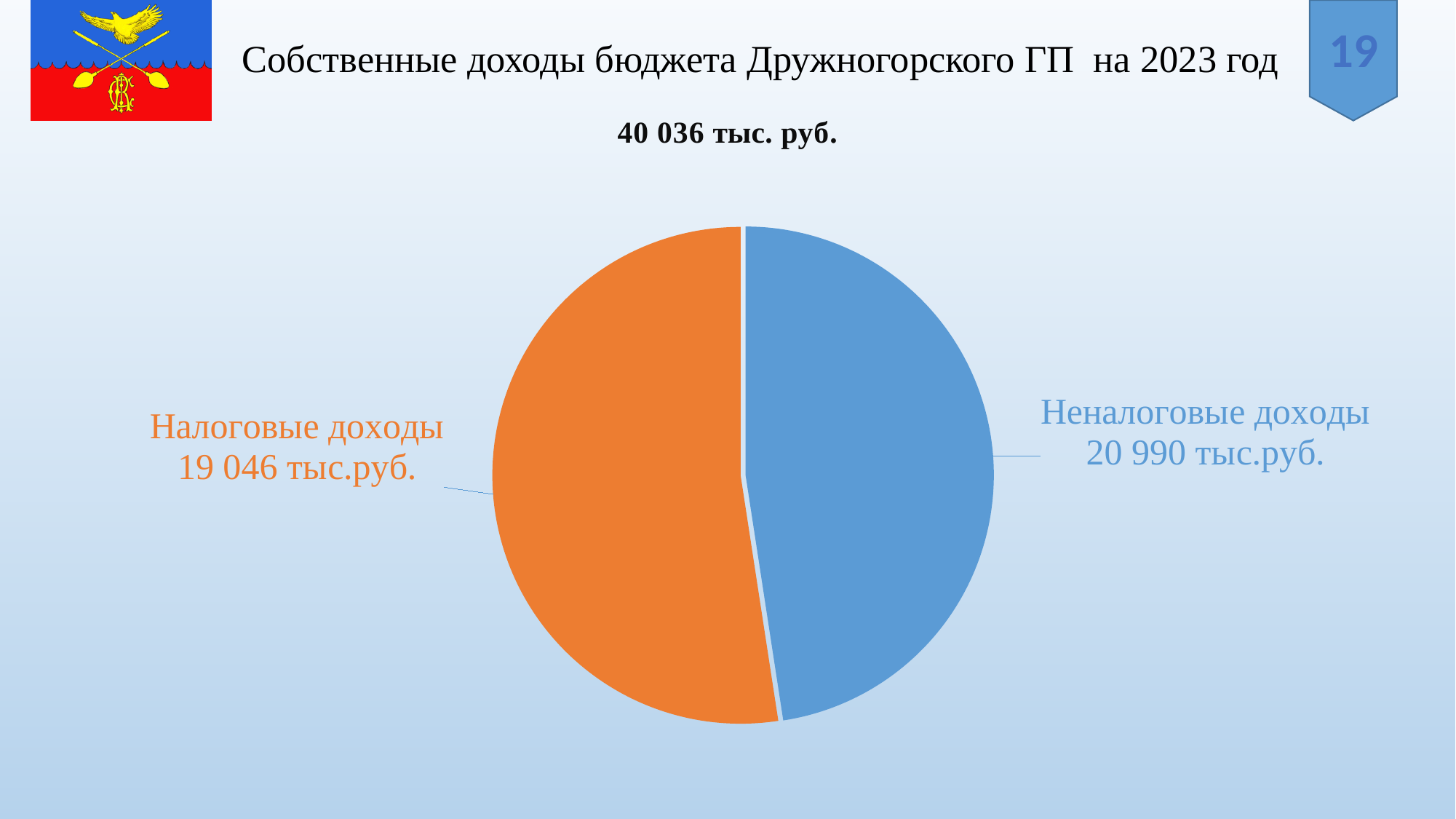
What is the total of the two slices shown on the slide? 40 036 тыс. руб. What is the value for Налоговые доходы? 19 046 тыс.руб. Which is larger, Налоговые доходы or Неналоговые доходы? Неналоговые доходы What is the value for Неналоговые доходы? 20 990 тыс.руб. Which category has the smallest slice of the pie? Налоговые доходы What kind of chart is shown on the slide? Pie chart What colour is the slice for Налоговые доходы? Orange What is the difference between Неналоговые доходы and Налоговые доходы? 1 944 тыс.руб. What is the title of the slide containing the chart? Собственные доходы бюджета Дружногорского ГП на 2023 год How many slices does the pie chart have? 2 Which category has the largest slice of the pie? Неналоговые доходы